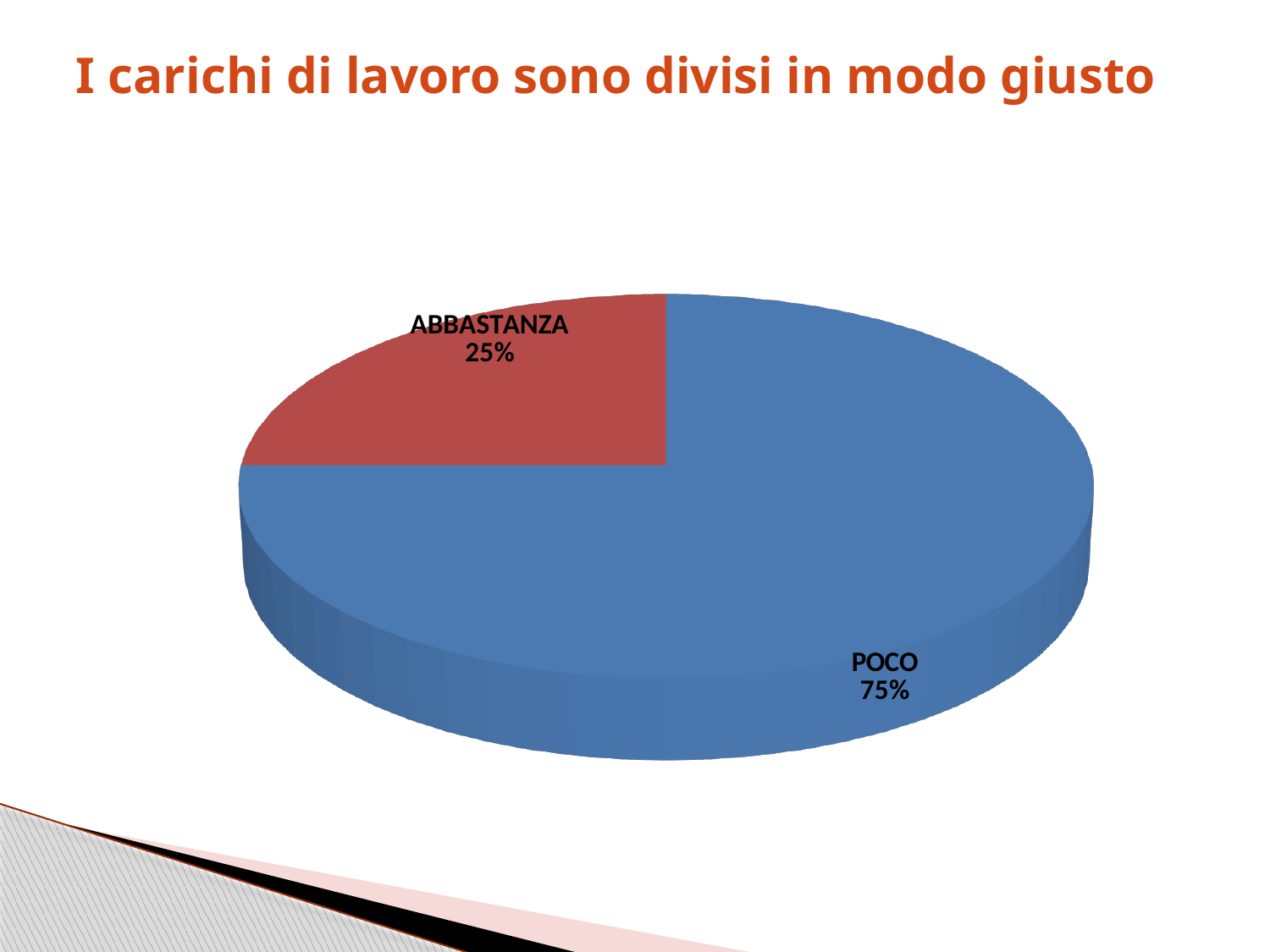
What is the title of the slide containing the pie chart? I carichi di lavoro sono divisi in modo giusto What kind of chart is shown on the slide? pie chart Which is larger, the slice for POCO or the slice for ABBASTANZA? POCO Which category has the largest slice of the pie? POCO What is the difference in percentage points between POCO and ABBASTANZA? 50% What share of the pie does POCO represent? 75% What colour is the slice for ABBASTANZA? red Which category has the smallest slice of the pie? ABBASTANZA What share of the pie does ABBASTANZA represent? 25% How many slices does the pie chart have? 2